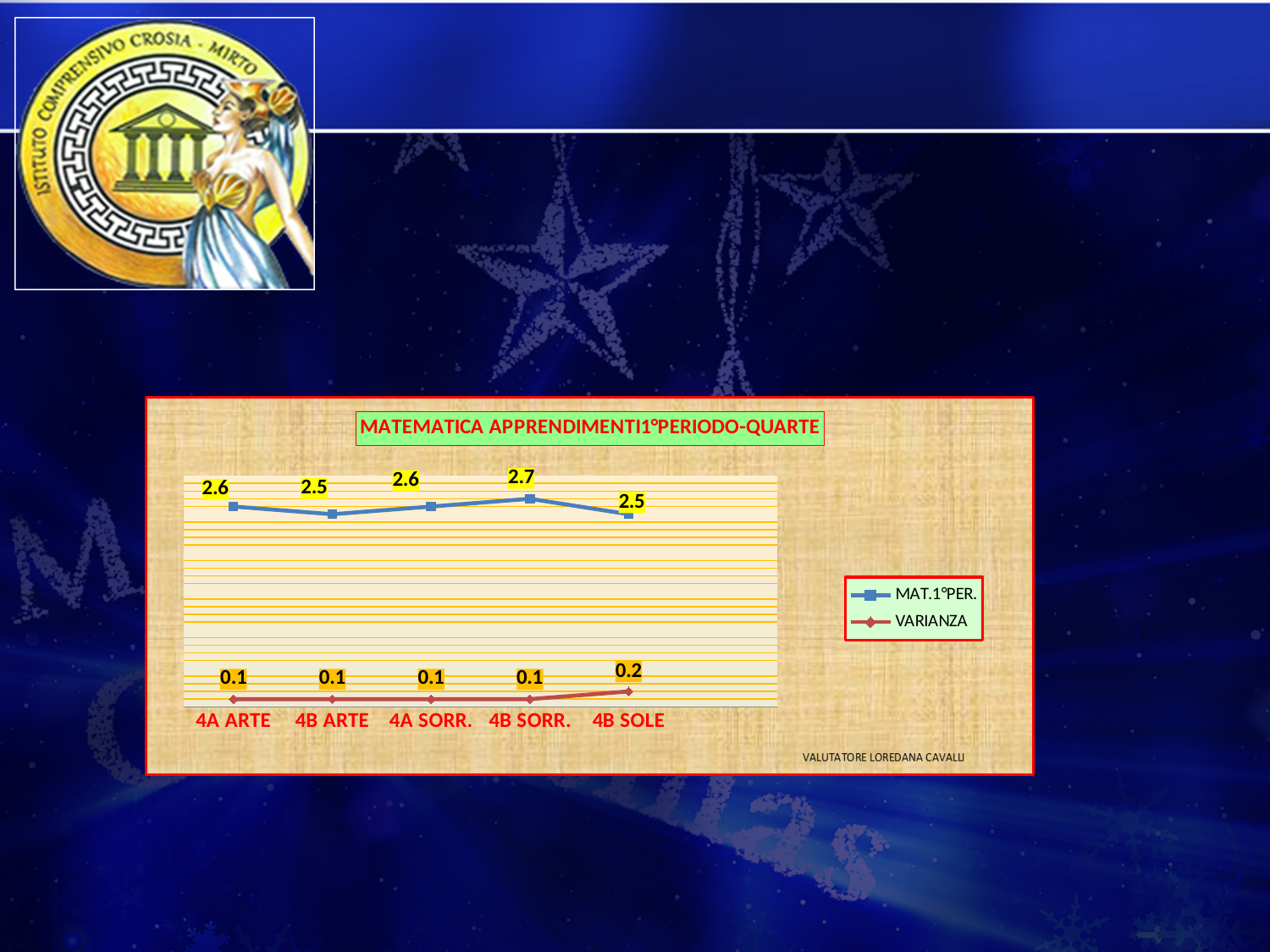
What is the title of the chart? MATEMATICA APPRENDIMENTI1°PERIODO-QUARTE What is the MAT.1°PER. value for 4B SORR.? 2.7 How many categories are shown on the x axis? 5 What is the difference between the MAT.1°PER. values for 4B SORR. and 4B SOLE? 0.2 Which category has the highest MAT.1°PER. value? 4B SORR. What kind of chart is shown? line chart How many series does the legend list? 2 What is the MAT.1°PER. value for 4A ARTE? 2.6 Which category has the highest VARIANZA value? 4B SOLE What is the VARIANZA value for 4B SOLE? 0.2 What is the VARIANZA value for 4A SORR.? 0.1 Which is larger, the MAT.1°PER. value for 4A ARTE or for 4B ARTE? 4A ARTE